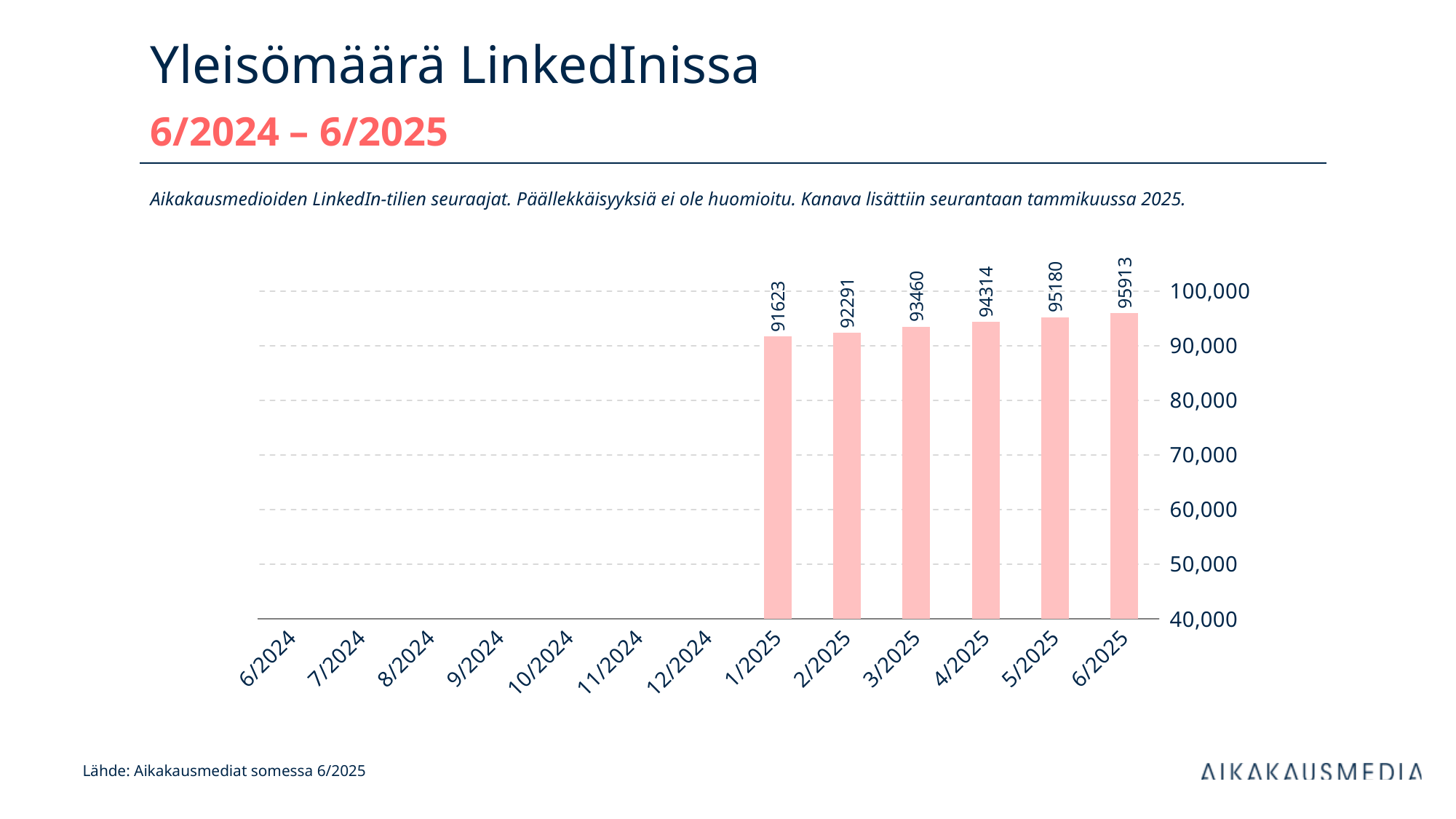
What is the value for 6/2025? 95913 Do the values rise or fall from 1/2025 to 6/2025? Rise Among the months with a plotted bar, which has the lowest value? 1/2025 What is the difference between the values for 3/2025 and 2/2025? 1169 What kind of chart is shown on the slide? Bar chart How many months have a plotted bar in the chart? 6 Which month has the highest value? 6/2025 Which is larger, the value for 5/2025 or the value for 2/2025? 5/2025 What is the value for 1/2025? 91623 Is the value for 3/2025 greater or less than 90,000? greater What is the difference between the values for 6/2025 and 1/2025? 4290 What is the value for 4/2025? 94314